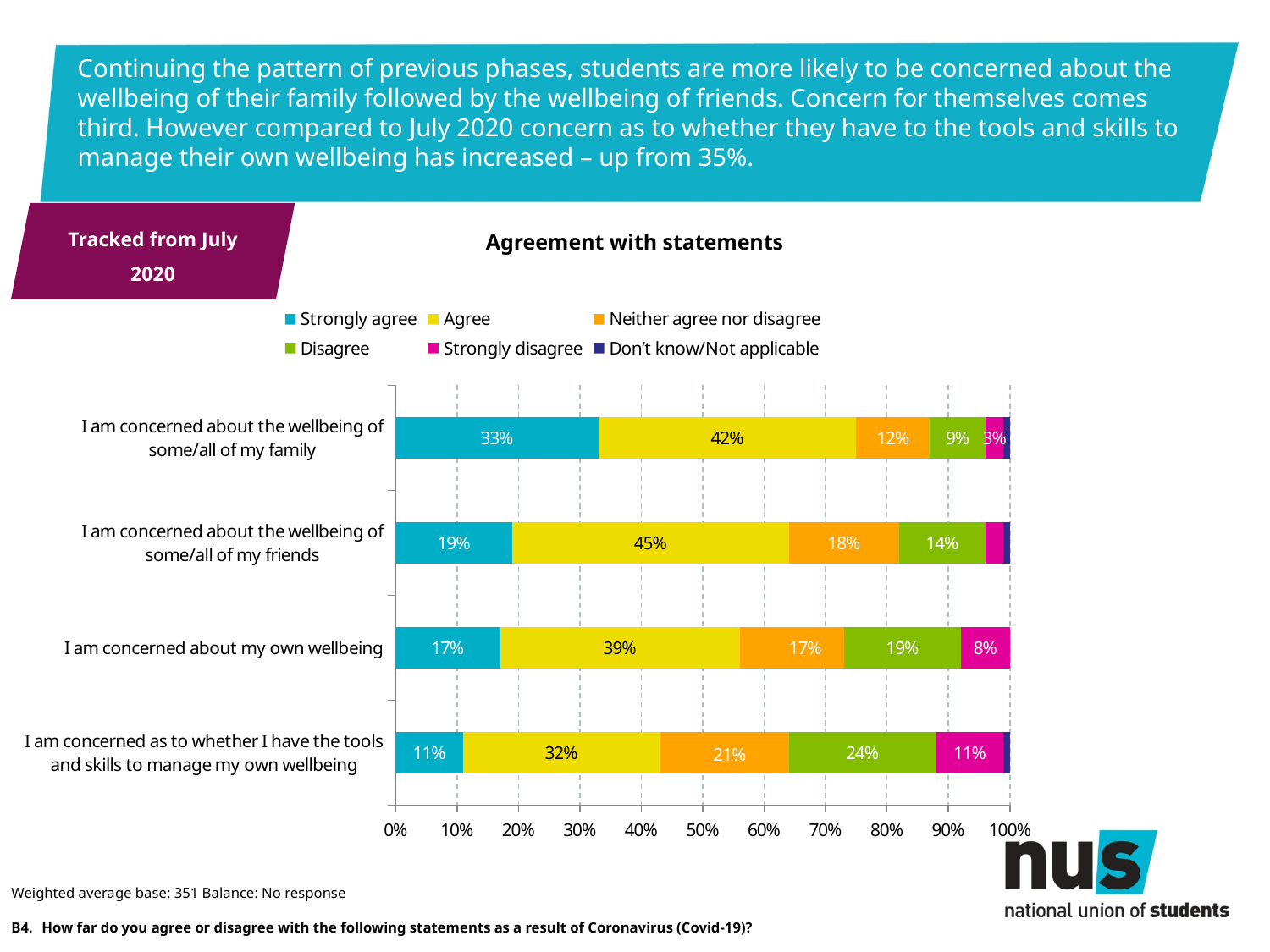
How many series does the legend list? 6 What percentage of students strongly disagree that they are concerned about their own wellbeing? 8% What percentage of students disagree that they are concerned as to whether they have the tools and skills to manage their own wellbeing? 24% What percentage of students agree that they are concerned about the wellbeing of some/all of their friends? 45% How many statements (categories) are plotted in the chart? 4 What is the difference between the 'Agree' percentage for concern about family wellbeing and the 'Agree' percentage for concern about the tools and skills to manage own wellbeing? 10% What is the title of the chart? Agreement with statements Which statement has the lowest 'Strongly agree' percentage? I am concerned as to whether I have the tools and skills to manage my own wellbeing Which is larger: the 'Neither agree nor disagree' percentage for concern about friends' wellbeing or for concern about family wellbeing? Concern about friends' wellbeing What type of chart is shown on the slide? Stacked bar chart What percentage of students strongly agree that they are concerned about the wellbeing of some/all of their family? 33% Which statement has the highest 'Strongly agree' percentage? I am concerned about the wellbeing of some/all of my family